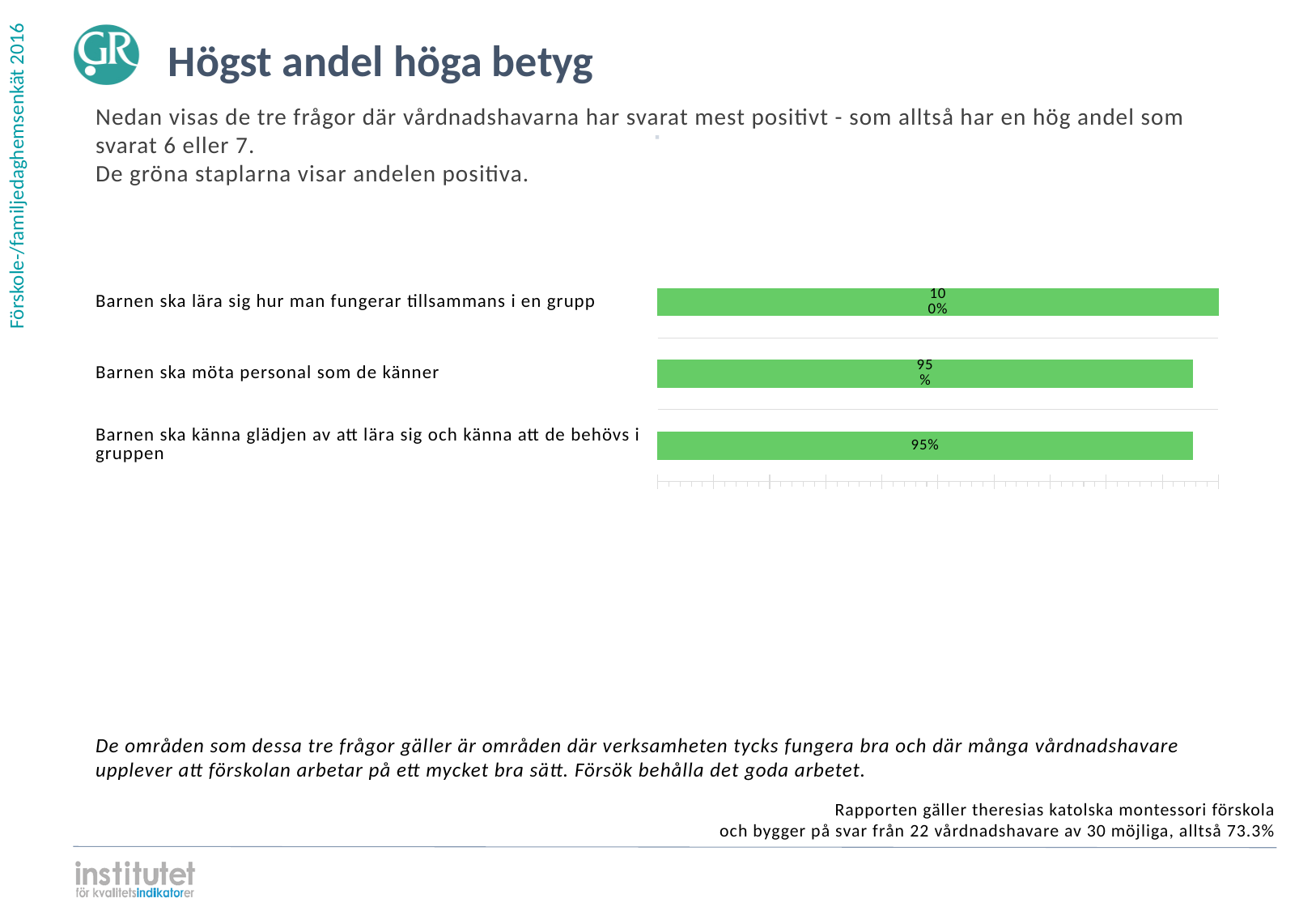
What colour are the bars in the chart? Green What is the value for "Barnen ska känna glädjen av att lära sig och känna att de behövs i gruppen"? 95% What is the difference between the value for "Barnen ska lära sig hur man fungerar tillsammans i en grupp" and the value for "Barnen ska möta personal som de känner"? 5 percentage points What is the title of the slide containing the chart? Högst andel höga betyg Which is larger: the value for "Barnen ska lära sig hur man fungerar tillsammans i en grupp" or the value for "Barnen ska möta personal som de känner"? Barnen ska lära sig hur man fungerar tillsammans i en grupp What kind of chart is shown on the slide? Bar chart What is the value for "Barnen ska lära sig hur man fungerar tillsammans i en grupp"? 100% How many categories are shown in the chart? 3 What is the value for "Barnen ska möta personal som de känner"? 95% Which category has the highest value? Barnen ska lära sig hur man fungerar tillsammans i en grupp